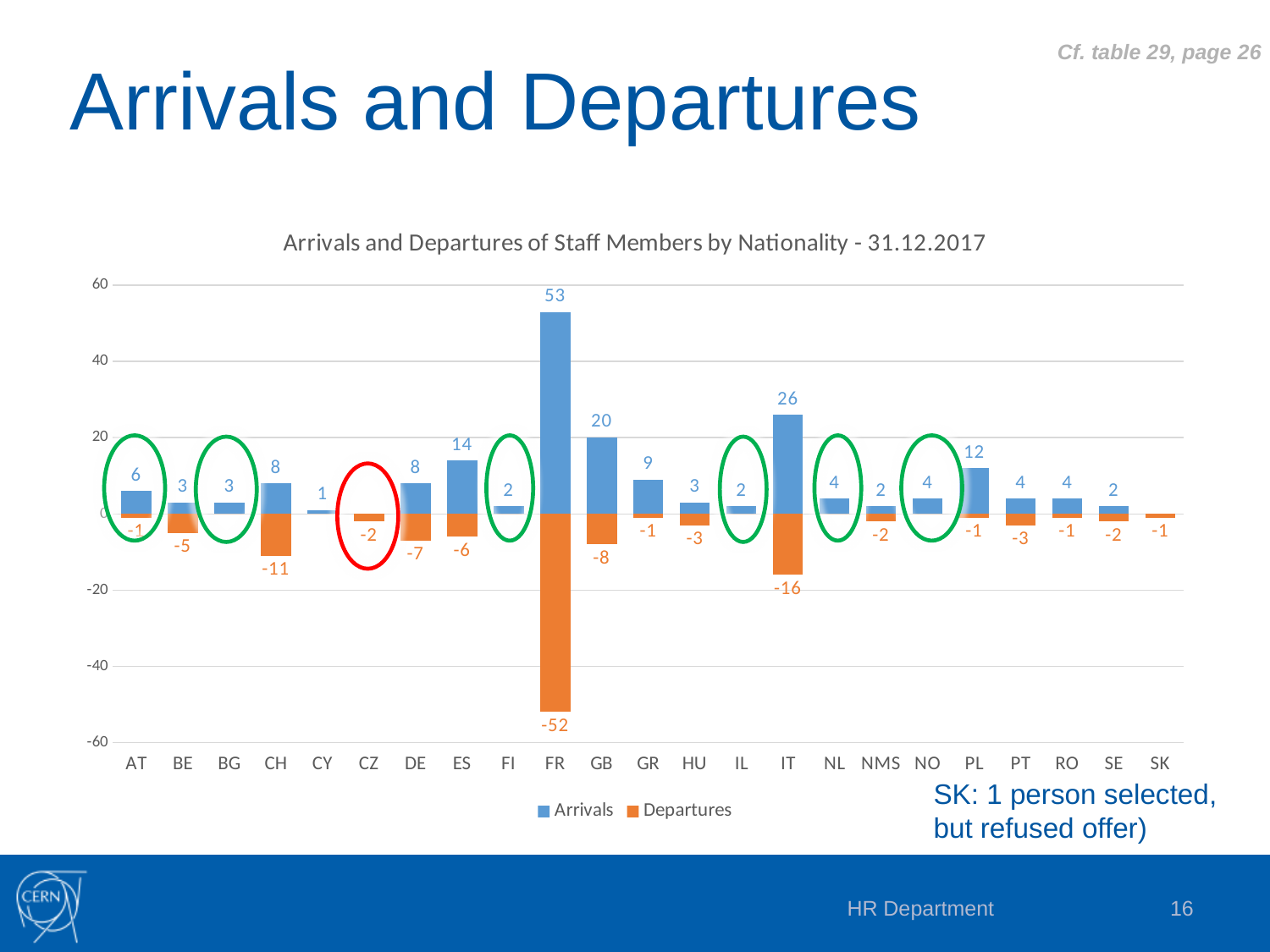
What is the Departures value for CH? -11 What is the title of the chart? Arrivals and Departures of Staff Members by Nationality - 31.12.2017 Which has a larger Arrivals value, GB or PL? GB Which nationality has the highest Arrivals value? FR How many nationality categories are shown on the x axis? 23 What is the Arrivals value for ES? 14 What is the Arrivals value for FR? 53 How many series does the legend list? 2 What is the difference between the Arrivals values for FR and IT? 27 What kind of chart is shown on the slide? Bar chart What is the Departures value for IT? -16 Which nationality has the lowest (most negative) Departures value? FR